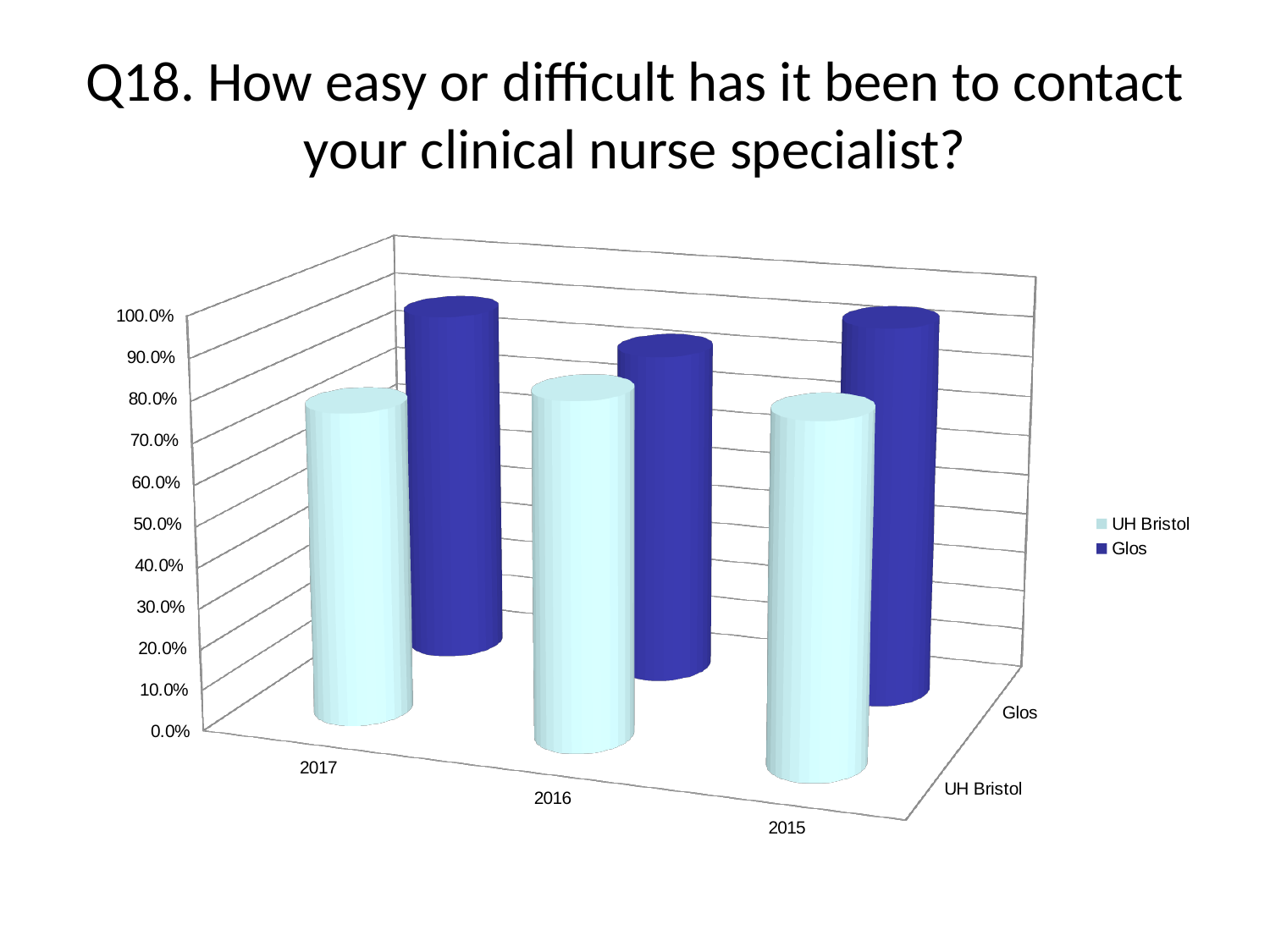
Is the value for Glos in 2015 greater or less than 60%? greater How many series does the legend list? 2 Is the value for Glos in 2017 greater or less than 50%? greater How many years are shown along the x axis of the chart? 3 Which two series are listed in the chart legend? UH Bristol and Glos Is the value for UH Bristol in 2015 greater or less than 50%? greater What is the title of the slide containing the chart? Q18. How easy or difficult has it been to contact your clinical nurse specialist? What kind of chart is shown on the slide? bar chart